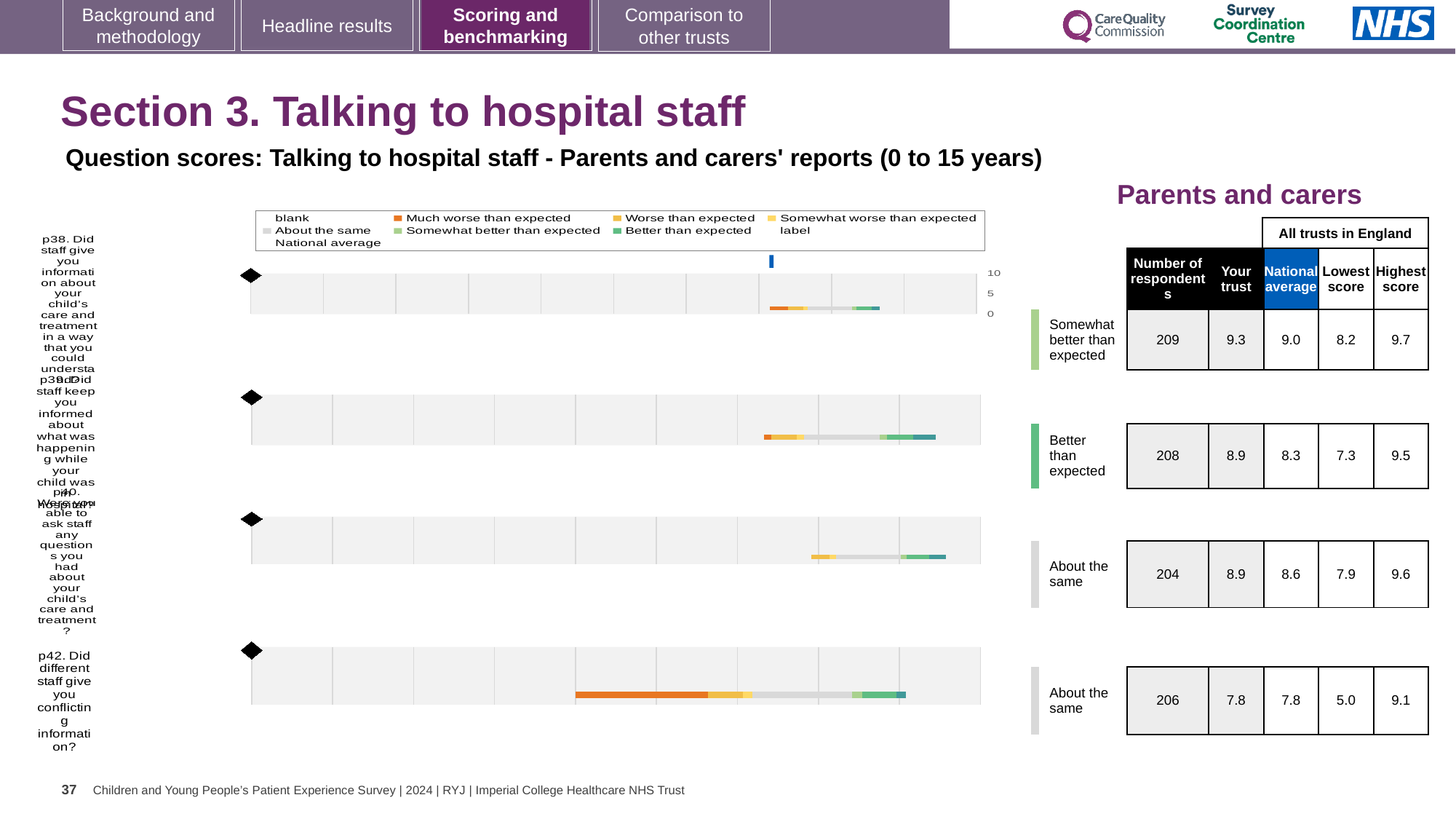
What is the highest value shown on the axis of the p38 chart? 10 What benchmark category is shown next to the p39 chart? Better than expected For p38, which is larger: the 'Your trust' score or the national average? Your trust Which question has the lowest 'Your trust' score in the table? p42 For p42, what is the difference between the highest score (9.1) and the lowest score (5.0) across all trusts in England? 4.1 In the table, what is the lowest score across all trusts in England for p42 (different staff giving conflicting information)? 5.0 In the table, what is the national average for p39 (staff keeping you informed about what was happening)? 8.3 In the legend, what colour represents 'Much worse than expected'? orange How many question charts (p38, p39, p40, p42) are shown on the slide? 4 In the table, how many respondents answered p40 (being able to ask staff any questions)? 204 What kind of chart is used to show the question scores for p38 to p42? bar chart In the table, what is the 'Your trust' score for p38 (staff giving information about your child's care in a way you could understand)? 9.3